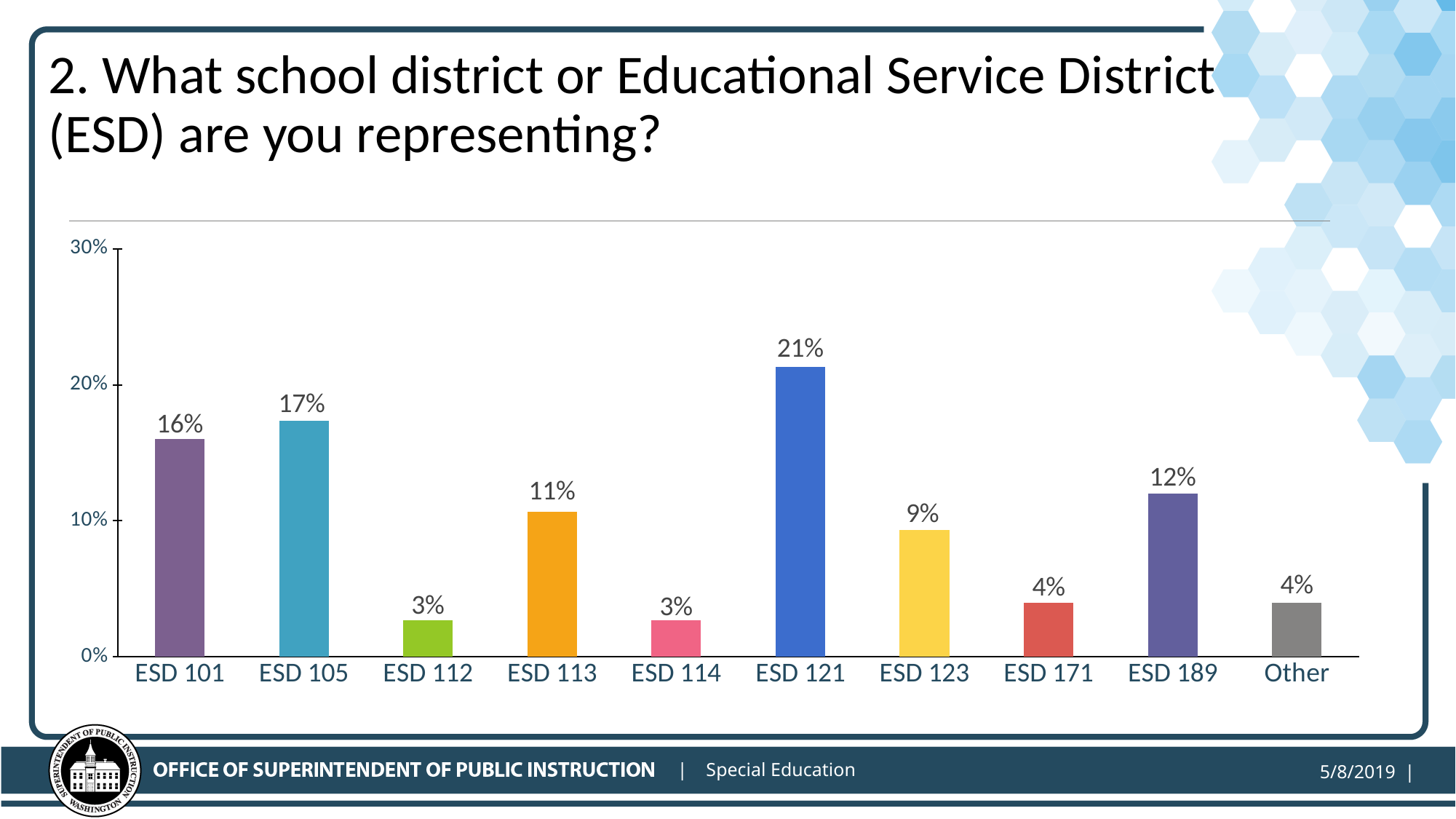
What percentage is shown for the Other category? 4% How many categories are shown on the x axis? 10 What is the highest value shown on the y axis? 30% What is the difference in percentage points between ESD 121 and ESD 101? 5% What is the value shown for ESD 105? 17% Which is larger, the value for ESD 189 or the value for ESD 123? ESD 189 What is the difference between the values for ESD 105 and ESD 189? 5% Is the value for ESD 113 greater or less than 10%? greater Which category has the lowest percentage, ESD 112 or ESD 113? ESD 112 Which category has the highest percentage? ESD 121 What percentage of respondents represent ESD 121? 21% What kind of chart is shown on the slide? Bar chart